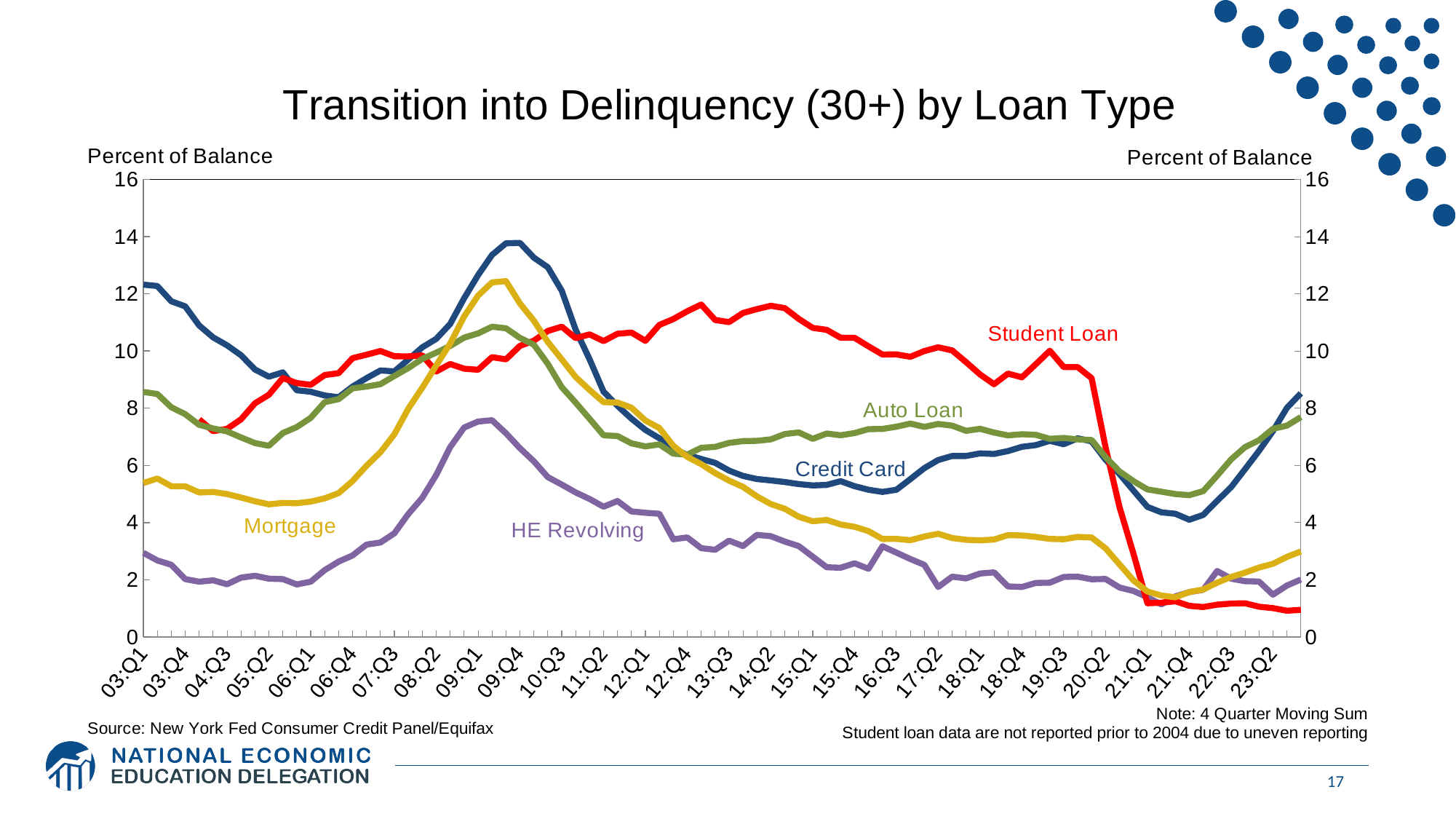
What is the label on the vertical axis of the chart? Percent of Balance What is the title of the chart? Transition into Delinquency (30+) by Loan Type Is the peak value of the Credit Card line around 09:Q4 greater or less than 12? greater At 14:Q2, which is larger: the Student Loan value or the Credit Card value? Student Loan Does the Student Loan line rise or fall between 19:Q3 and 21:Q1? fall Which loan type has the lowest value at the right end of the chart (23:Q2)? Student Loan Is the peak value of the HE Revolving line around 09:Q1 greater or less than 6? greater At 09:Q4, which is larger: the Credit Card value or the HE Revolving value? Credit Card What kind of chart is shown on the slide? line chart Is the value of the Student Loan line at 21:Q1 greater or less than 2? less How many loan types are plotted as lines on the chart? 5 Which loan type reaches the highest peak on the chart? Credit Card